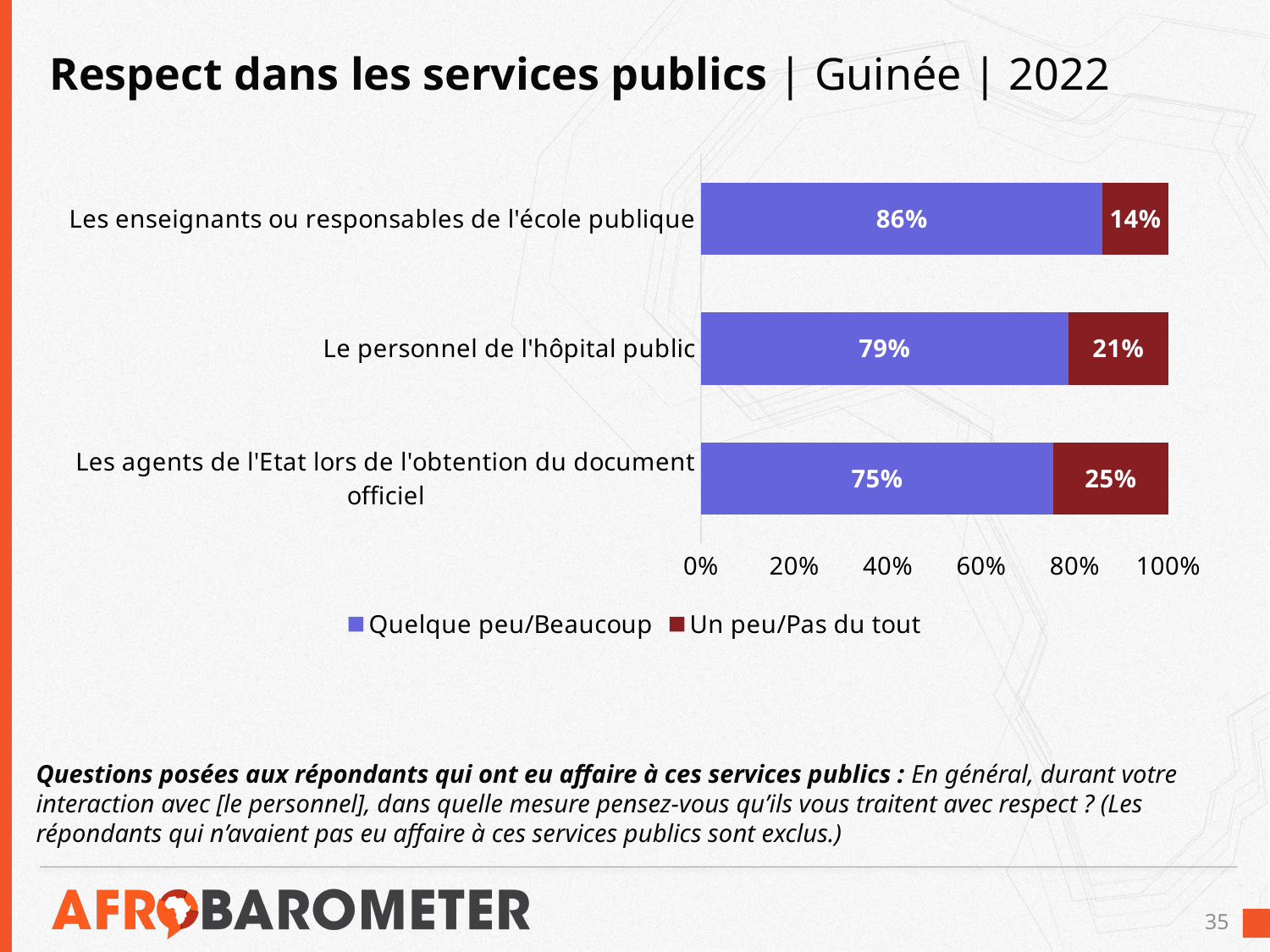
Which is larger: the "Un peu/Pas du tout" value for "Le personnel de l'hôpital public" or for "Les agents de l'Etat lors de l'obtention du document officiel"? Les agents de l'Etat lors de l'obtention du document officiel How many categories are shown in the chart? 3 What is the value of "Un peu/Pas du tout" for "Les enseignants ou responsables de l'école publique"? 14% How many series does the legend list? 2 Which category has the lowest value for "Quelque peu/Beaucoup"? Les agents de l'Etat lors de l'obtention du document officiel Which category has the highest value for "Quelque peu/Beaucoup"? Les enseignants ou responsables de l'école publique Which series is shown in dark red in the legend? Un peu/Pas du tout What is the value of "Un peu/Pas du tout" for "Les agents de l'Etat lors de l'obtention du document officiel"? 25% What is the total of the stacked bar for "Le personnel de l'hôpital public"? 100% What kind of chart is shown on the slide? Stacked bar chart What is the value of "Quelque peu/Beaucoup" for "Le personnel de l'hôpital public"? 79% What is the difference between the "Quelque peu/Beaucoup" values for "Les enseignants ou responsables de l'école publique" and "Le personnel de l'hôpital public"? 7 percentage points